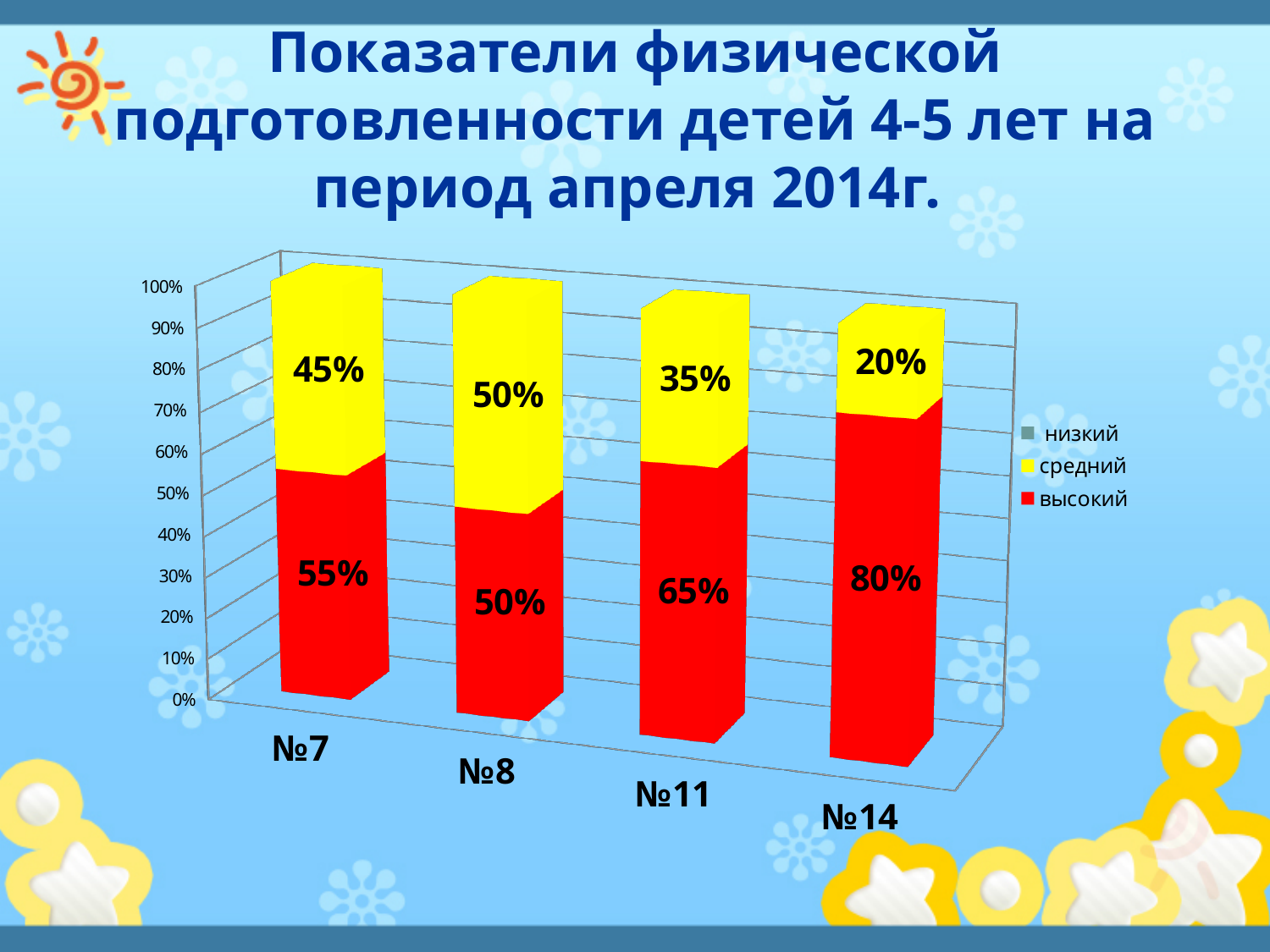
What is the value of the средний series for №8? 50% What is the value of the высокий series for №14? 80% What is the difference between the высокий values for №14 and №7? 25% How many series does the legend list? 3 How many categories are shown on the x axis? 4 Which is larger: the средний value for №7 or the средний value for №11? №7 What colour represents the высокий series? Red What is the value of the высокий series for №11? 65% Which category has the lowest value for the средний series? №14 Which category has the highest value for the высокий series? №14 What kind of chart is shown on the slide? Stacked bar chart What is the value of the средний series for №7? 45%